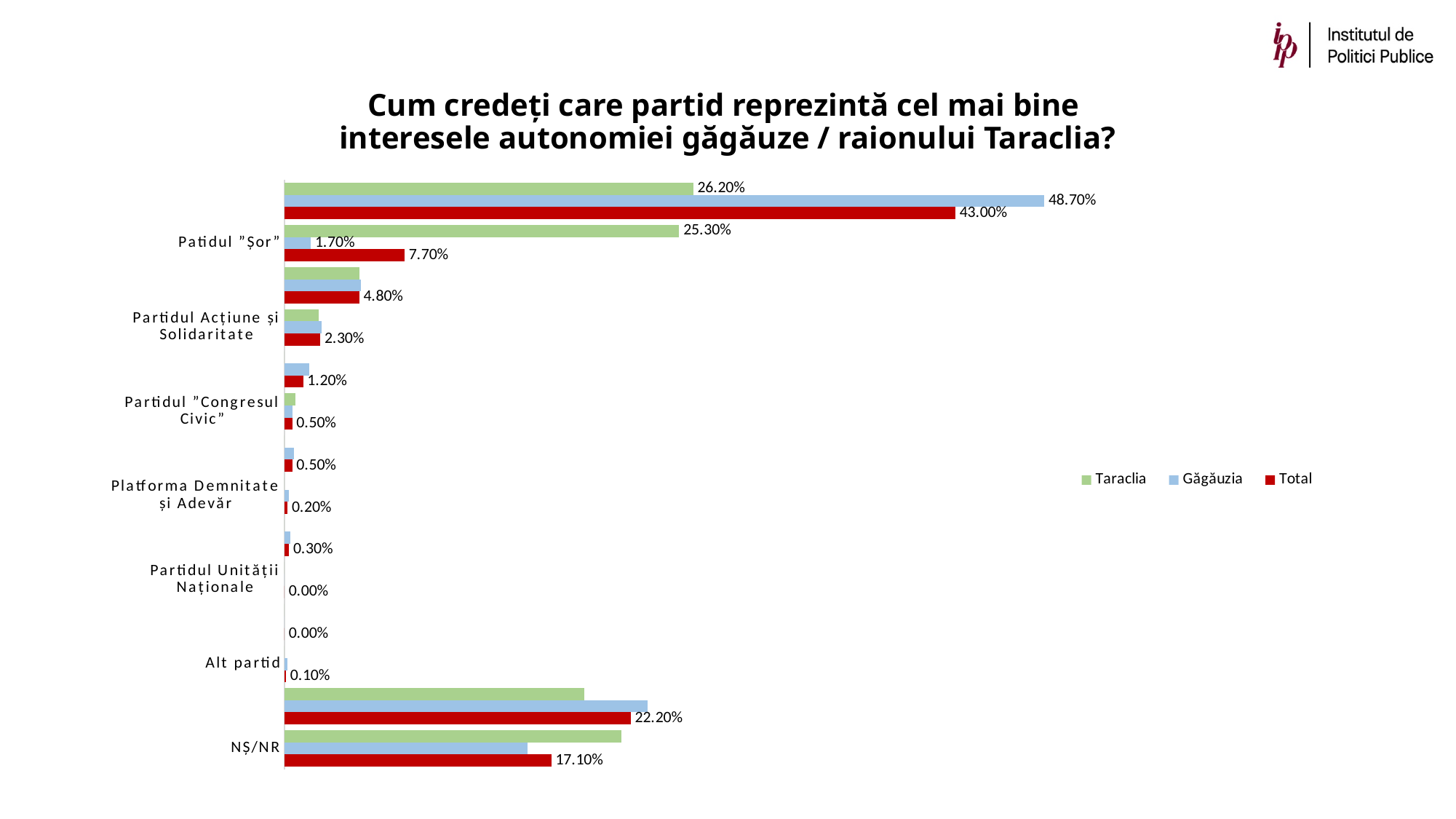
In the topmost group of bars, which is larger: the Taraclia value or the Găgăuzia value? Găgăuzia What is the Total value for the bottommost group of bars? 17.10% In the topmost group of bars, what is the value for Taraclia? 26.20% In the topmost group of bars, how much larger is the Găgăuzia value than the Total value? 5.70% In the topmost group of bars, what is the value for Găgăuzia? 48.70% What is the difference between the Taraclia value in the topmost group (26.20%) and the Taraclia value in the second group (25.30%)? 0.90% In the topmost group of bars, what is the value for Total? 43.00% What kind of chart is shown on the slide? Bar chart How many series does the legend list? 3 What is the highest Total value labelled on the chart? 43.00% Which colour represents the Total series? Red What are the three series named in the legend? Taraclia, Găgăuzia, Total